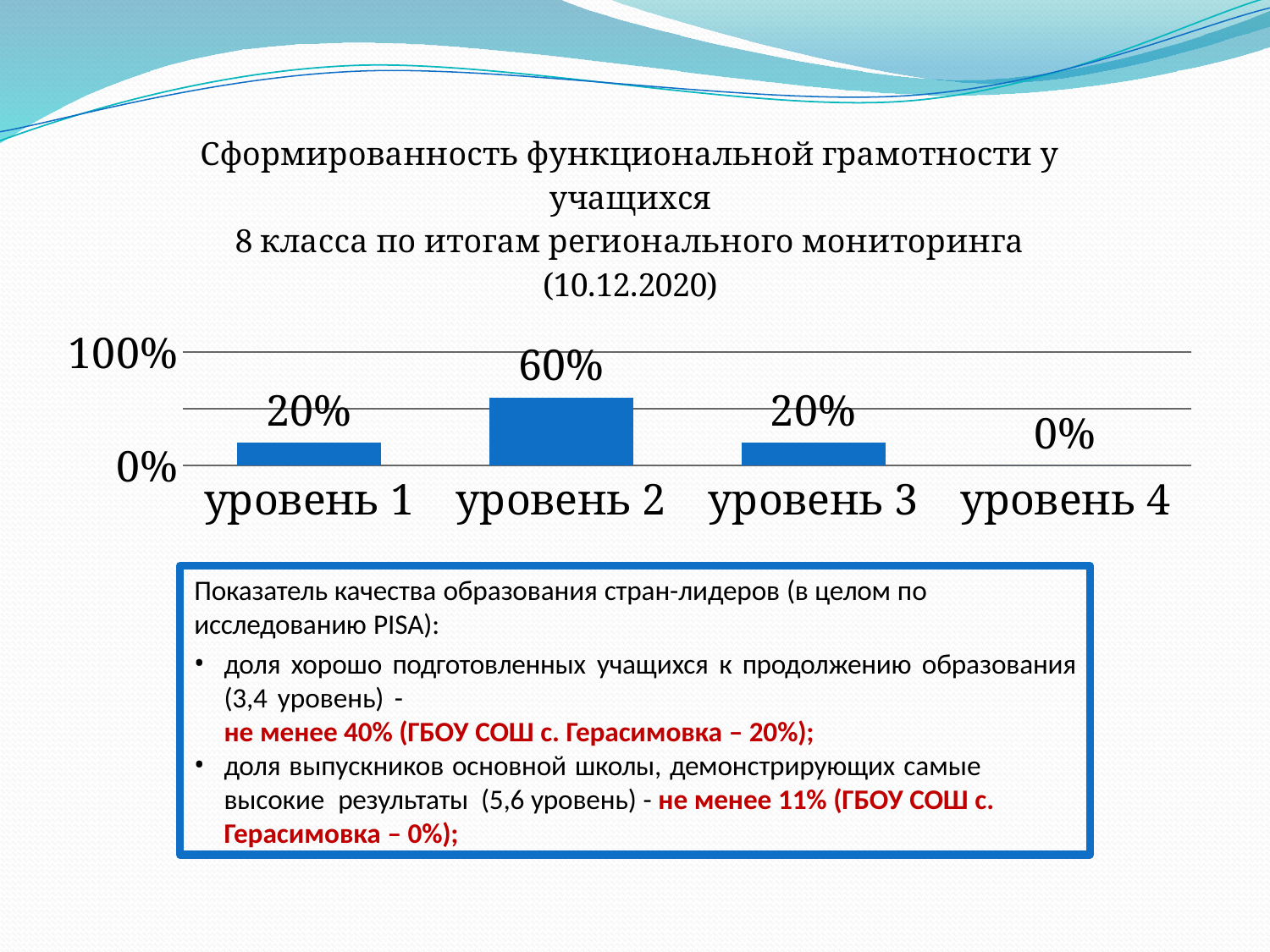
What kind of chart is shown on the slide? bar chart What is the highest tick label shown on the vertical axis? 100% Which category has the highest value? уровень 2 Which category has the lowest value? уровень 4 What is the value for уровень 4? 0% What is the value for уровень 2? 60% Which is larger, the value for уровень 2 or the value for уровень 1? уровень 2 Is the value for уровень 2 greater or less than 50%? greater What is the total of the values for уровень 1 and уровень 3? 40% How many categories are shown on the x axis? 4 What is the difference between the values for уровень 2 and уровень 3? 40% What is the value for уровень 1? 20%